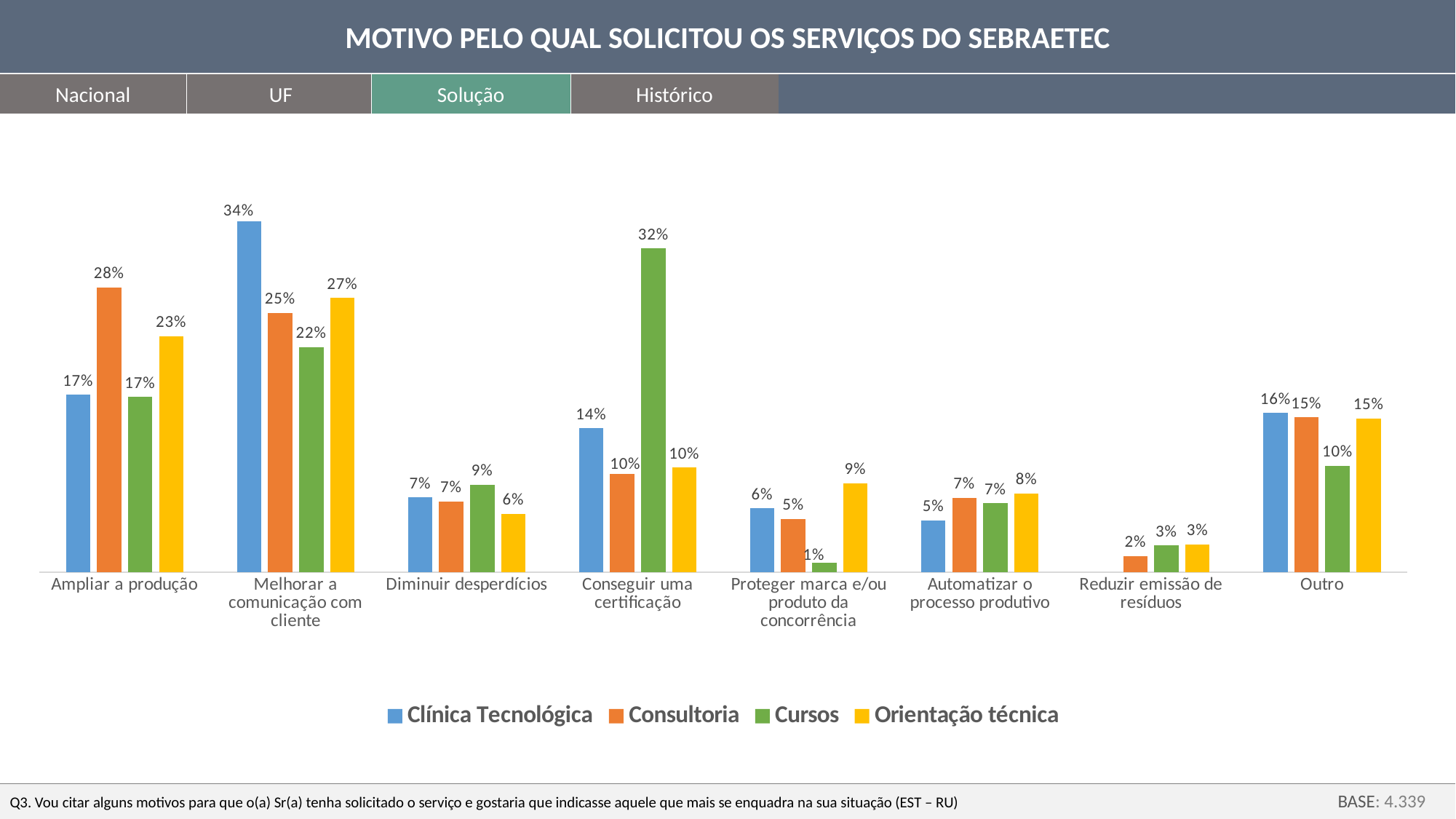
What is the value for Clínica Tecnológica in the category 'Melhorar a comunicação com cliente'? 34% Which category has the highest value for the Consultoria series? Ampliar a produção What is the value for Orientação técnica in the category 'Ampliar a produção'? 23% How many categories are shown on the x axis? 8 What type of chart is shown on the slide? bar chart What is the difference between the Clínica Tecnológica value and the Cursos value in 'Melhorar a comunicação com cliente'? 12% What is the value for Cursos in the category 'Conseguir uma certificação'? 32% What is the difference between the Cursos value and the Consultoria value in 'Conseguir uma certificação'? 22% How many series does the legend list? 4 In the category 'Outro', which is larger: Clínica Tecnológica or Cursos? Clínica Tecnológica Which series is shown in green in the legend? Cursos Which category has the lowest value for the Cursos series? Proteger marca e/ou produto da concorrência